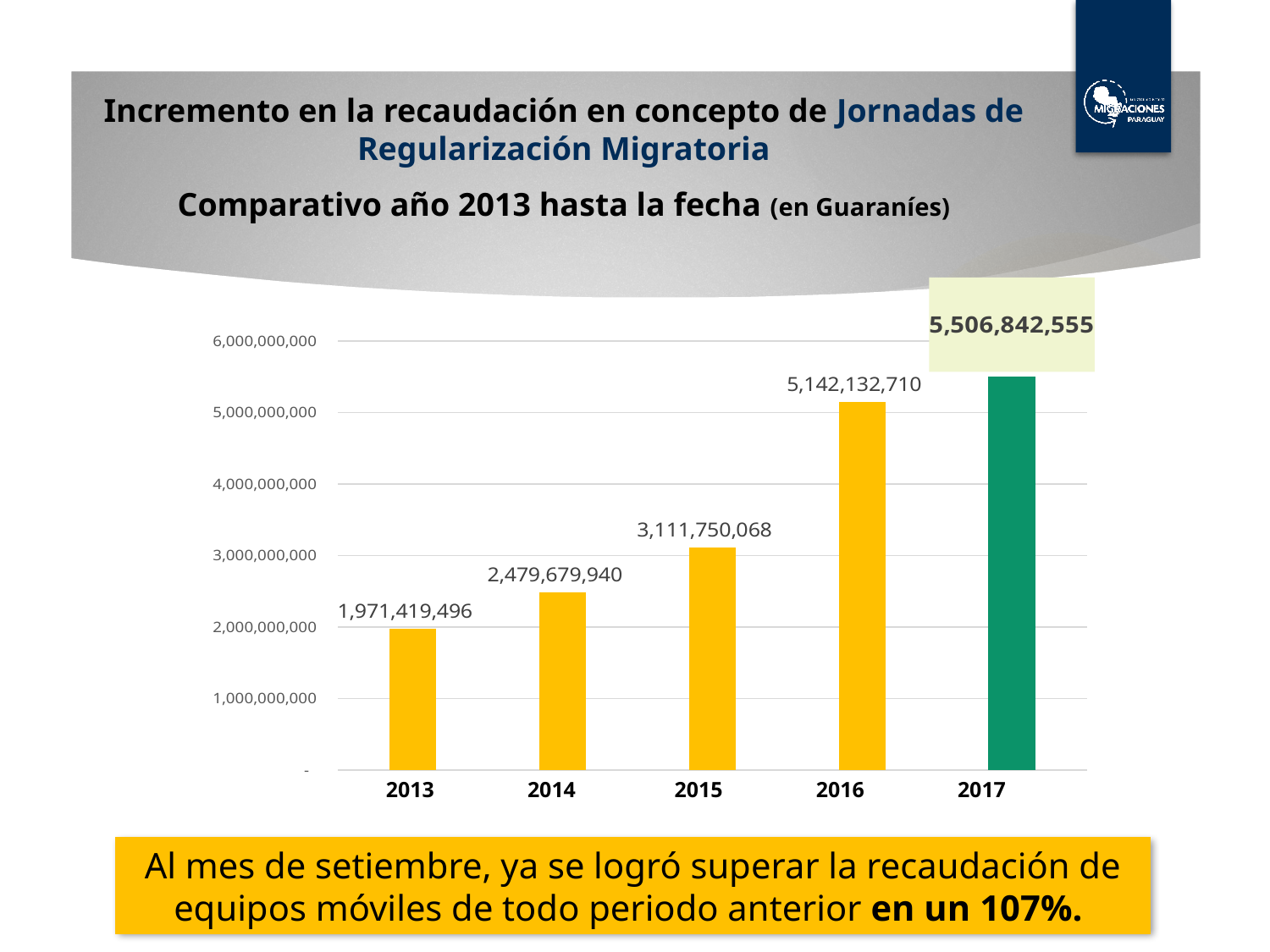
How many years are shown on the chart? 5 What is the difference between the values for 2016 and 2015? 2,030,382,642 Which is larger, the value for 2014 or the value for 2015? 2015 What is the value for 2013? 1,971,419,496 Do the values rise or fall from 2013 to 2017? rise Which year has the highest value? 2017 What is the value for 2015? 3,111,750,068 Is the value for 2016 greater or less than 4,000,000,000? greater What kind of chart is shown on the slide? bar chart What is the value for 2017? 5,506,842,555 What is the difference between the values for 2017 and 2016? 364,709,845 Which year has the lowest value? 2013